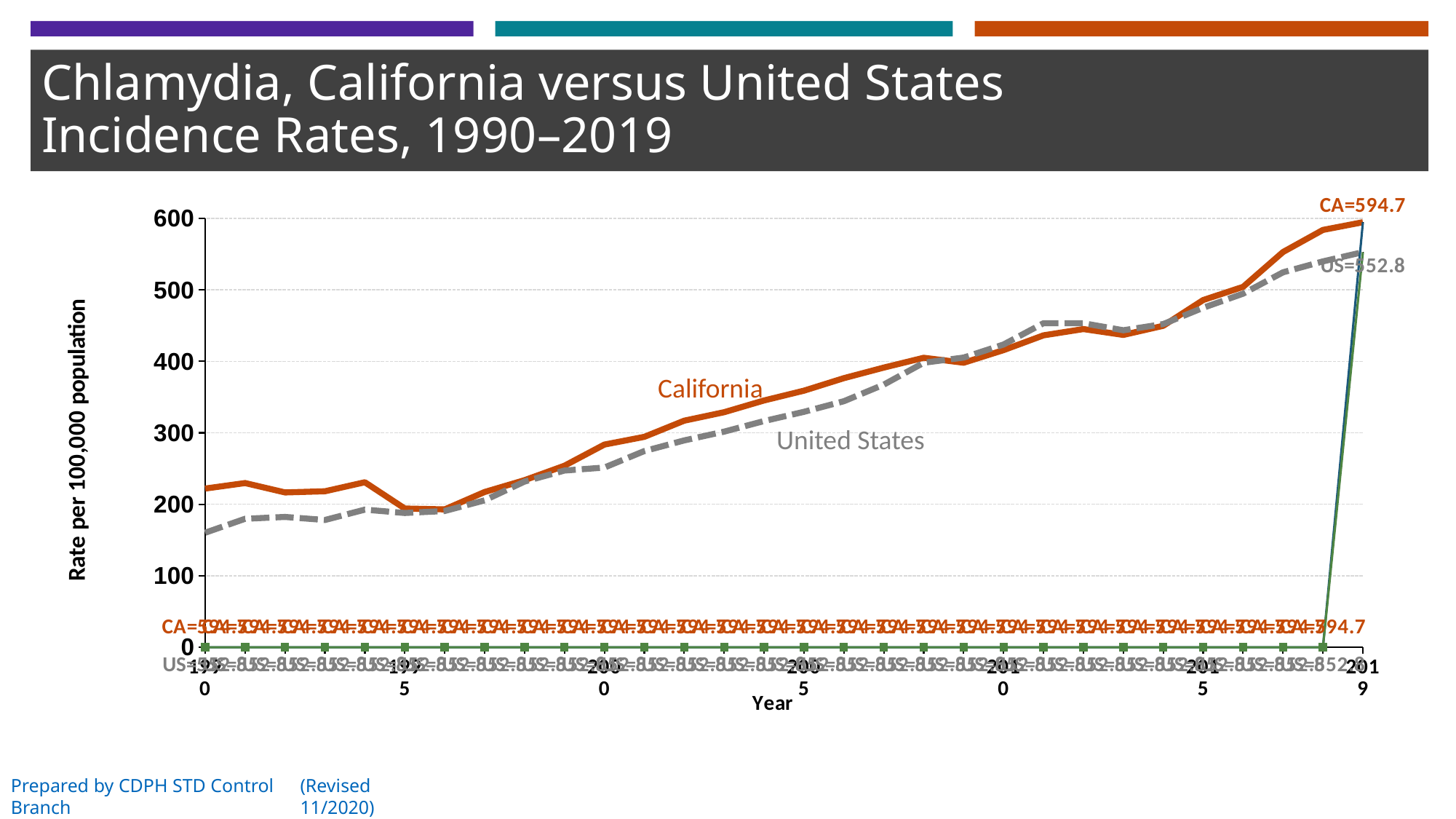
In 2019, which has the higher labeled rate, California or the United States? California Is the United States rate in 2000 greater or less than 300? less What is the difference between the California and United States rates labeled for 2019? 41.9 What is the label on the vertical axis of the chart? Rate per 100,000 population What is the California chlamydia incidence rate labeled for 2019? 594.7 Which two series are labeled on the chart? California and United States What kind of chart is shown on the slide? line chart Do the incidence rates generally rise or fall from 1990 to 2019? rise Is the California rate in 2005 greater or less than 300? greater What is the United States chlamydia incidence rate labeled for 2019? 552.8 Is the United States rate in 1990 greater or less than 200? less